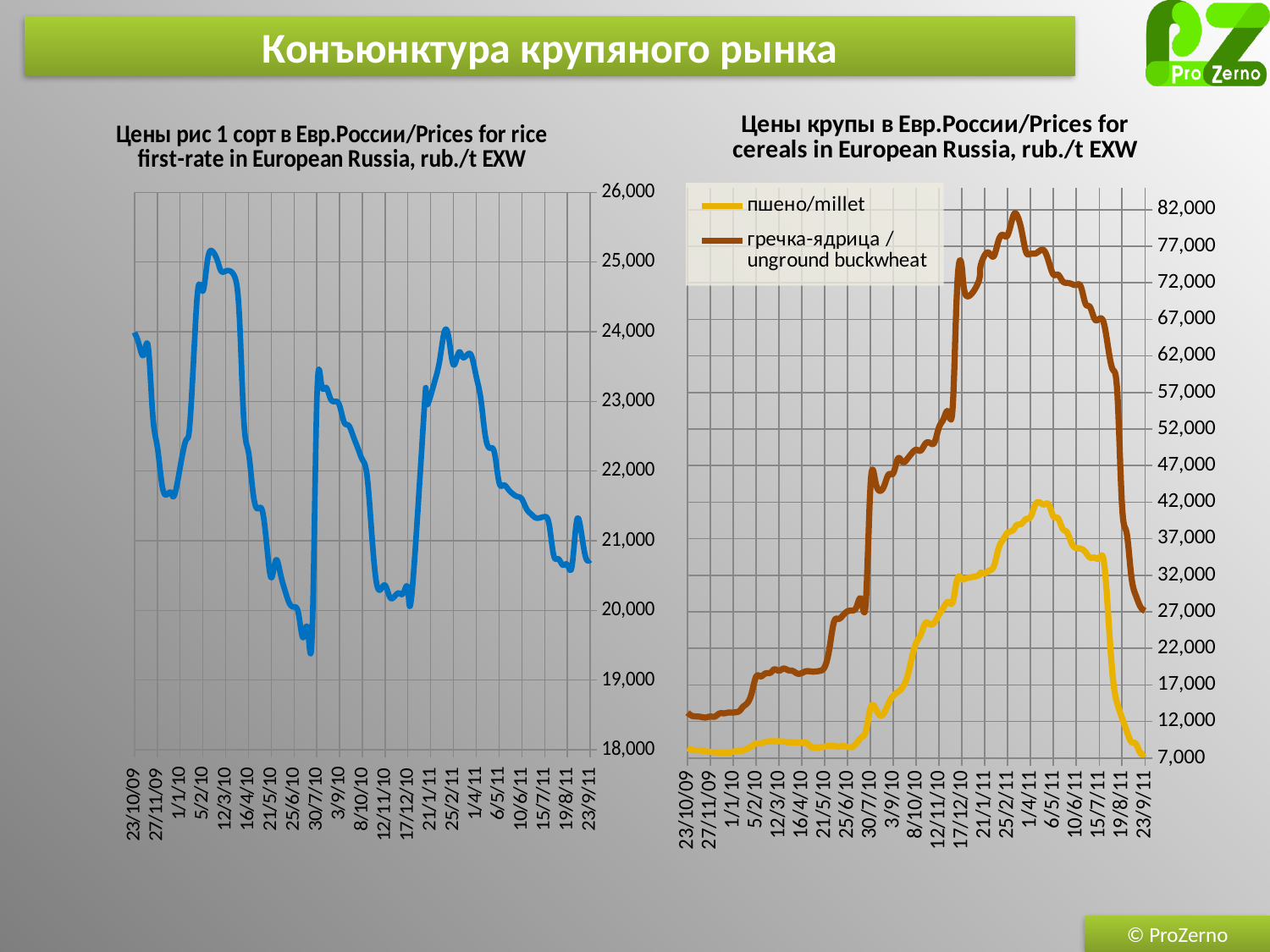
How many series does the legend of the right chart, 'Prices for cereals in European Russia', list? 2 In the right chart, 'Prices for cereals in European Russia', which series is drawn in brown? гречка-ядрица / unground buckwheat In the right chart, 'Prices for cereals in European Russia', is the peak unground buckwheat value around 25/2/11 greater or less than 77,000? greater In the left chart, 'Prices for rice first-rate in European Russia', is the value at 23/10/09 greater or less than 23,000? greater What kind of chart is the left chart, 'Prices for rice first-rate in European Russia'? line chart In the right chart, 'Prices for cereals in European Russia', is the unground buckwheat value at 23/10/09 greater or less than 17,000? less In the right chart, 'Prices for cereals in European Russia', which series is drawn in yellow? пшено/millet In the left chart, 'Prices for rice first-rate in European Russia', do the values rise or fall from 25/2/11 to 23/9/11? fall In the right chart, 'Prices for cereals in European Russia', which series has the larger value at 1/4/11, millet or unground buckwheat? unground buckwheat